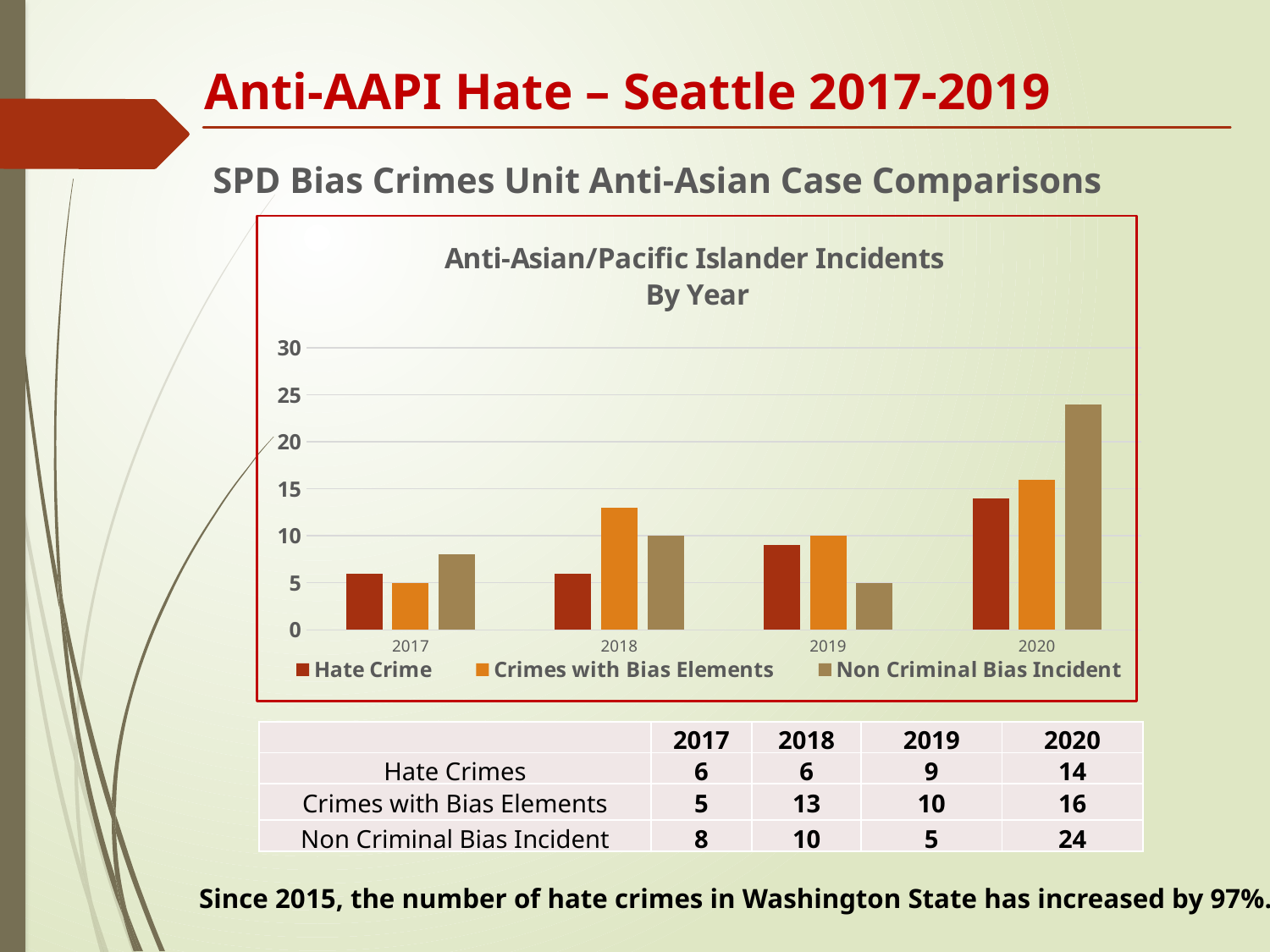
How many series does the chart legend list? 3 What is the difference between the Non Criminal Bias Incident value in 2020 and in 2019? 19 In which year is the Non Criminal Bias Incident value highest? 2020 Is the value for Non Criminal Bias Incident in 2020 greater or less than 20? greater Which is larger in 2018: Hate Crime or Non Criminal Bias Incident? Non Criminal Bias Incident What is the value for Hate Crime in 2020? 14 What is the title of the chart? Anti-Asian/Pacific Islander Incidents By Year What is the value for Crimes with Bias Elements in 2018? 13 In which year is the Crimes with Bias Elements value lowest? 2017 How many years are shown on the x axis of the chart? 4 What is the value for Non Criminal Bias Incident in 2019? 5 What kind of chart is shown on the slide? Bar chart